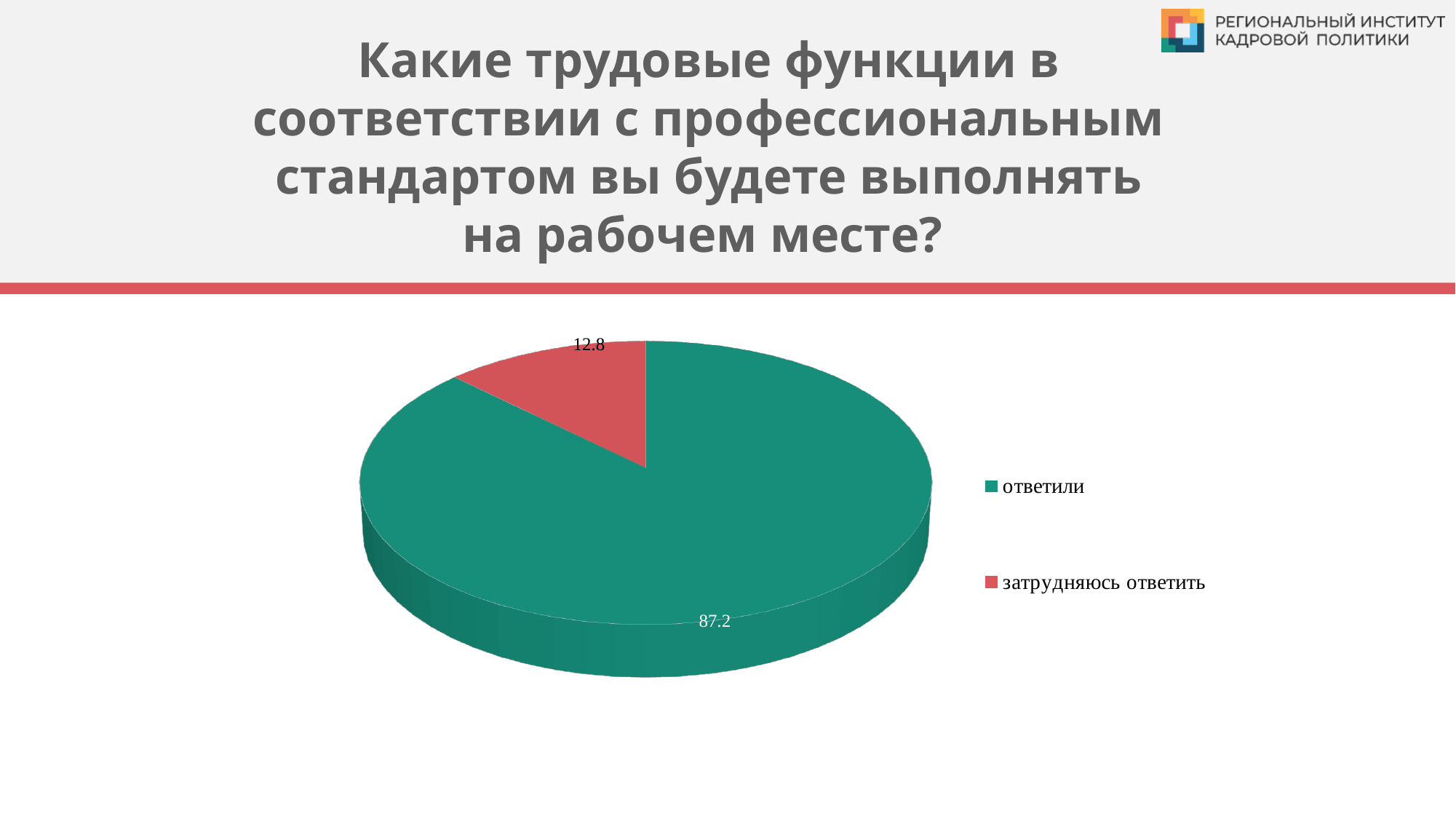
How many slices does the pie chart have? 2 What colour is the "ответили" slice? green What kind of chart is shown on the slide? pie chart Which category has the largest slice of the pie? ответили How many entries does the legend list? 2 What is the difference between the values for "ответили" and "затрудняюсь ответить"? 74.4 What value is shown for the "ответили" slice? 87.2 What colour is the "затрудняюсь ответить" slice? red Which category has the smallest slice of the pie? затрудняюсь ответить What is the total of the two slice values shown on the pie chart? 100 Which is larger, the value for "ответили" or for "затрудняюсь ответить"? ответили What value is shown for the "затрудняюсь ответить" slice? 12.8